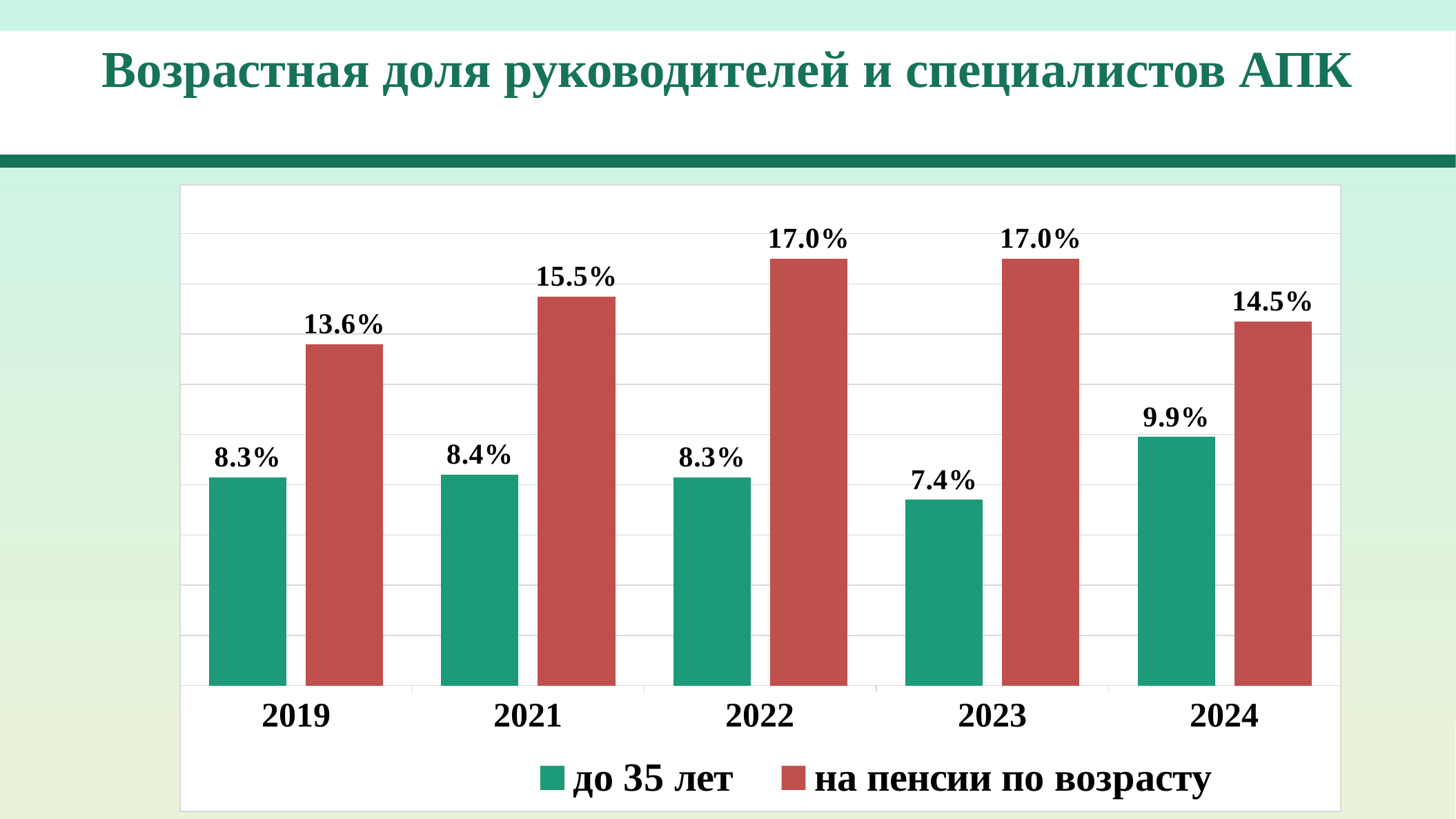
How many years are shown on the x axis? 5 Which is larger in 2021: the value for "до 35 лет" or for "на пенсии по возрасту"? на пенсии по возрасту What is the difference between the "на пенсии по возрасту" and "до 35 лет" values in 2022? 8.7% What kind of chart is shown on the slide? Bar chart In which year is the value for "до 35 лет" highest? 2024 In which year is the value for "на пенсии по возрасту" lowest? 2019 What is the difference between the "на пенсии по возрасту" values in 2024 and 2019? 0.9% What is the value for "до 35 лет" in 2024? 9.9% What is the value for "до 35 лет" in 2023? 7.4% How many series does the legend list? 2 What is the value for "на пенсии по возрасту" in 2019? 13.6% In which year is the value for "до 35 лет" lowest? 2023